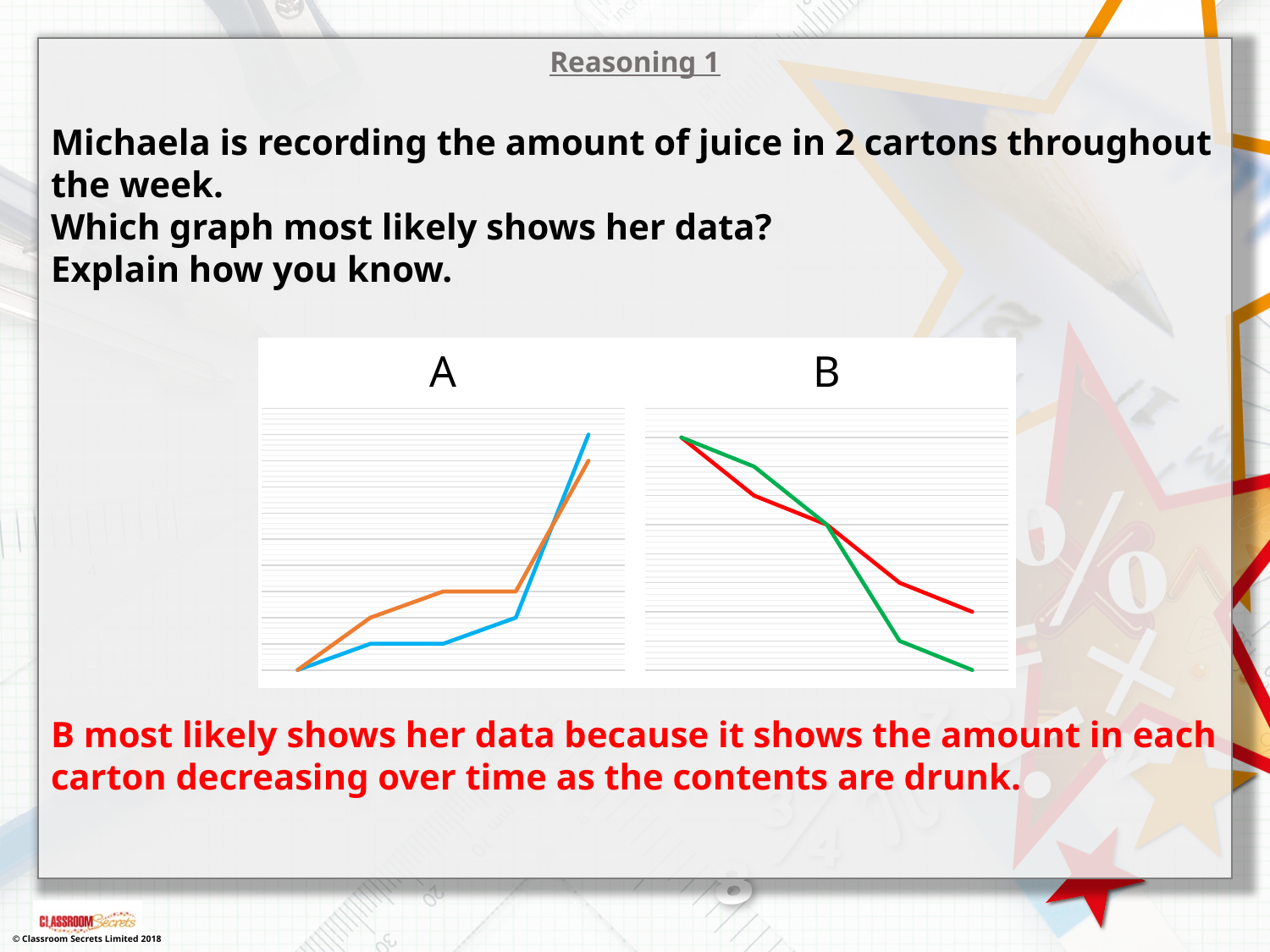
How many lines are plotted in chart B? 2 In chart A, which line ends higher at the right-hand side, the blue line or the orange line? blue line How many data points does each line in chart B have? 5 Which of the two charts shows the amount decreasing over time? B How many lines are plotted in chart A? 2 What colours are the two lines in chart B? green and red In chart A, at the middle point, which line is higher, the blue line or the orange line? orange line What kind of chart is chart A? line chart In chart B, do the values rise or fall from left to right? fall What kind of chart is chart B? line chart In chart A, do the values rise or fall from left to right? rise In chart B, which line ends lower at the right-hand side, the green line or the red line? green line